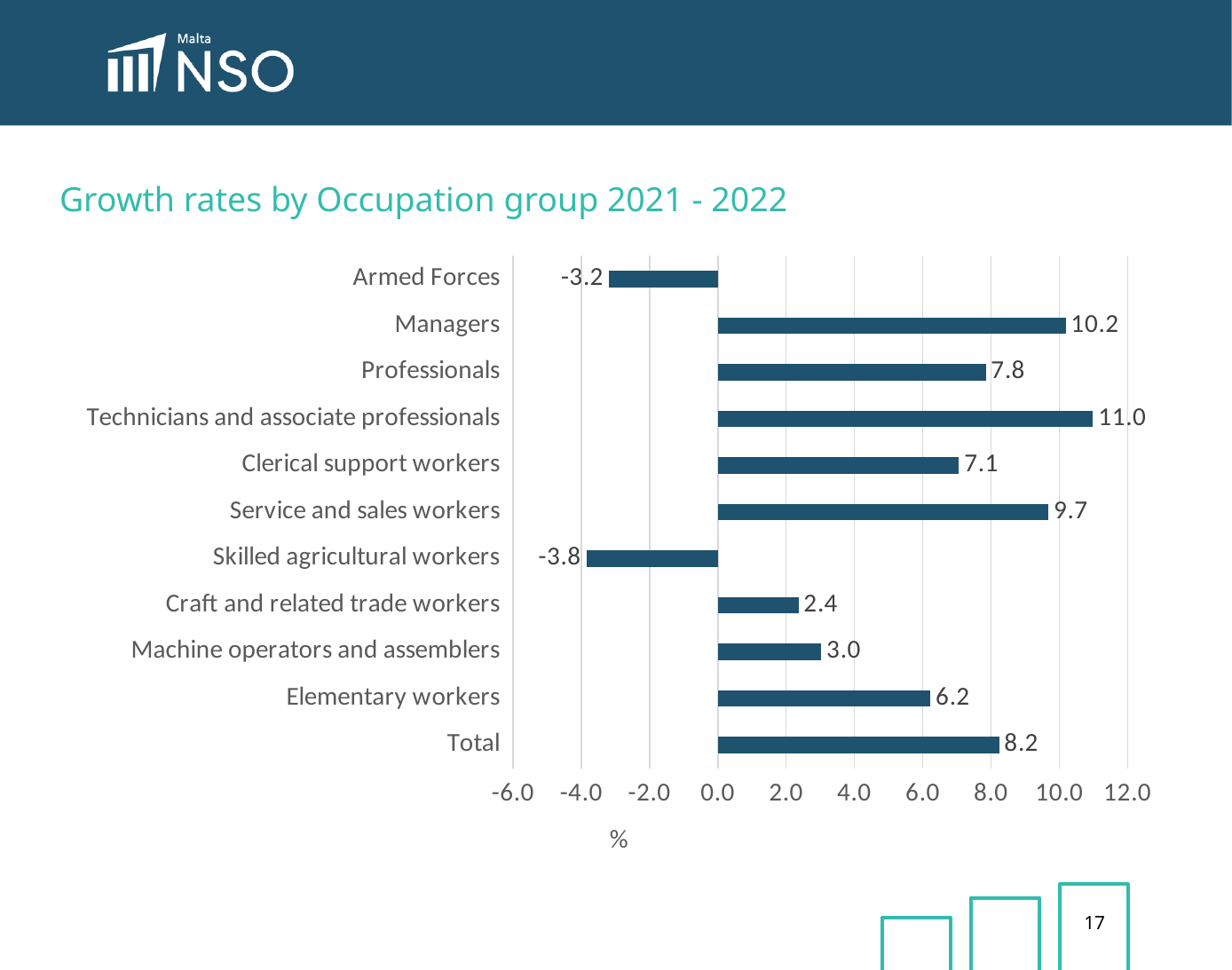
What is the title of the chart? Growth rates by Occupation group 2021 - 2022 What kind of chart is shown on the slide? Bar chart What is the growth rate for Skilled agricultural workers? -3.8 How many occupation groups have a negative growth rate? 2 Which occupation group has the lowest growth rate? Skilled agricultural workers Which has a higher growth rate, Service and sales workers or Clerical support workers? Service and sales workers Which occupation group has the highest growth rate? Technicians and associate professionals What unit is shown on the x axis of the chart? % What is the growth rate for Managers? 10.2 What is the difference between the growth rates for Managers and Professionals? 2.4 How many occupation groups (including Total) are shown on the chart? 11 What is the growth rate for the Total category? 8.2